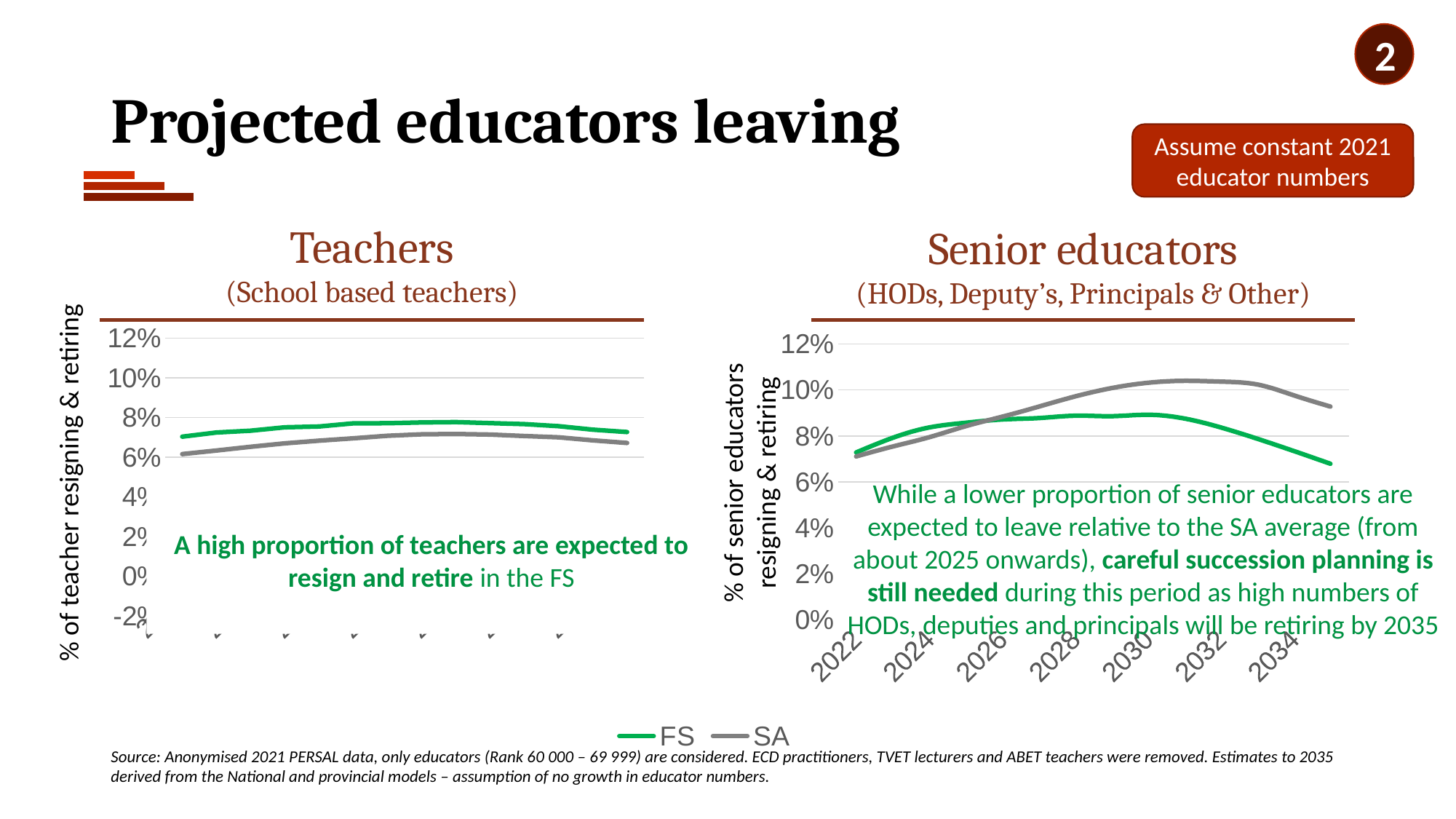
In the Senior educators chart, which series is higher in 2030, FS or SA? SA In the Senior educators chart, what is the first year shown on the x axis? 2022 In the Teachers chart, which series is higher throughout, FS or SA? FS How many series does the legend list? 2 What kind of chart is the Senior educators chart? line chart What kind of chart is the Teachers chart? line chart In the Teachers chart, is the value for FS greater or less than 6% at every point? greater In the Senior educators chart, does the FS line rise or fall between 2030 and 2034? fall In the Senior educators chart, is the peak value for SA greater or less than 10%? greater In the Senior educators chart, is the value for FS in 2034 greater or less than 8%? less Which colour represents the SA series in the legend? grey